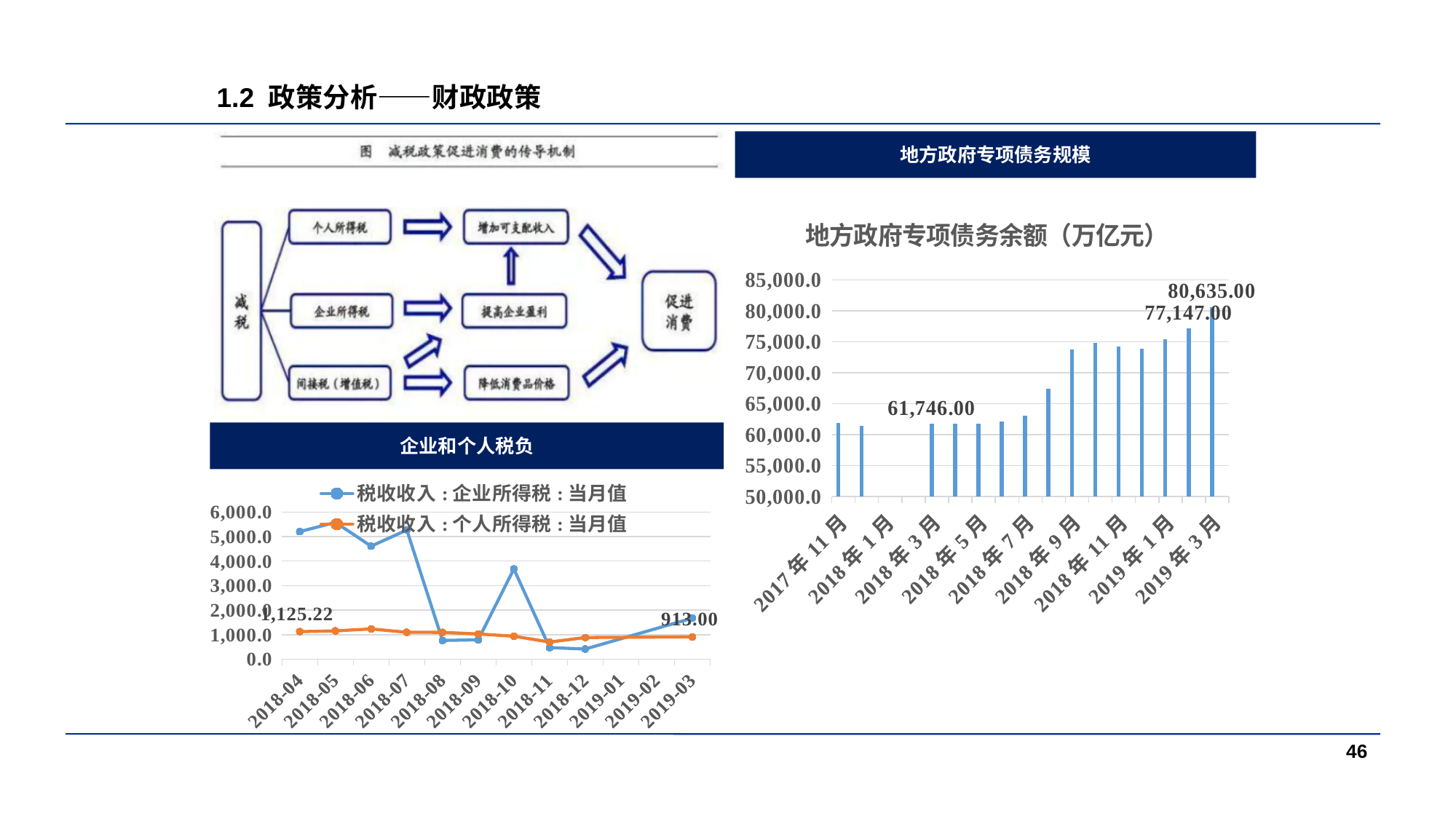
On the chart titled 地方政府专项债务余额（万亿元）, what is the labeled value for 2019年3月? 80,635.00 On the 企业和个人税负 chart, what is the difference between the labeled values 1,125.22 and 913.00? 212.22 On the 企业和个人税负 chart, what is the labeled value of 税收收入:个人所得税:当月值 for 2019-03? 913.00 On the 企业和个人税负 chart, what is the labeled value of 税收收入:个人所得税:当月值 for 2018-04? 1,125.22 On the 企业和个人税负 chart, how many series does the legend list? 2 On the chart titled 地方政府专项债务余额（万亿元）, do the values generally rise or fall from 2017年11月 to 2019年3月? rise On the chart titled 地方政府专项债务余额（万亿元）, is the value for 2018年9月 greater or less than 70,000.0? greater On the chart titled 地方政府专项债务余额（万亿元）, which month has the highest bar? 2019年3月 On the chart titled 地方政府专项债务余额（万亿元）, what is the difference between the labeled values 80,635.00 and 77,147.00? 3,488.00 On the chart titled 地方政府专项债务余额（万亿元）, is the value for 2017年11月 greater or less than 65,000.0? less On the 企业和个人税负 chart, which series has the larger value at 2018-10, 税收收入:企业所得税:当月值 or 税收收入:个人所得税:当月值? 税收收入:企业所得税:当月值 What kind of chart is the one titled 地方政府专项债务余额（万亿元）? bar chart